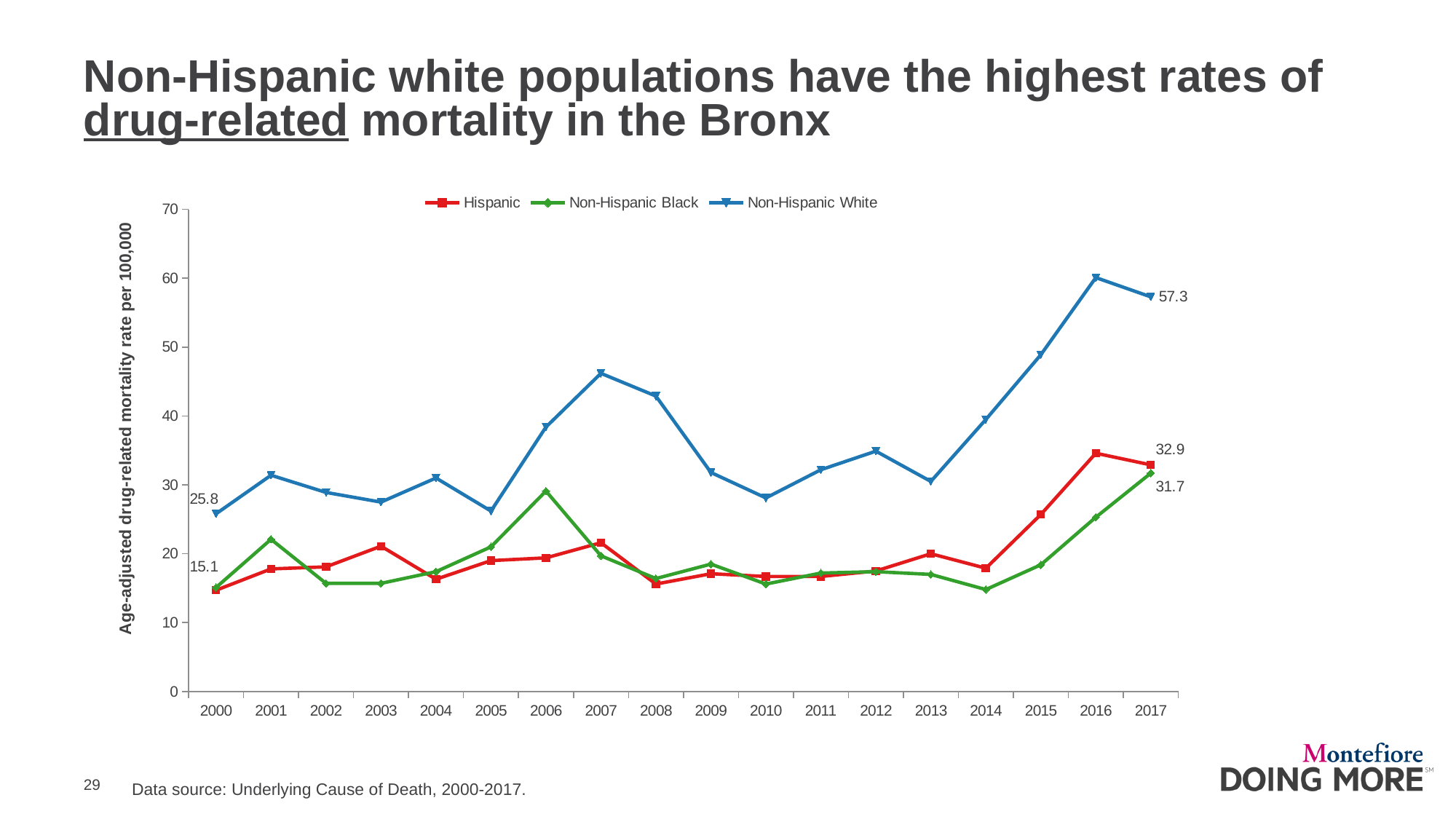
By how much did the Non-Hispanic White rate increase from 2000 to 2017? 31.5 How many years are shown on the x axis? 18 What is the value for the Non-Hispanic Black series in 2017? 31.7 What is the value for the Non-Hispanic White series in 2000? 25.8 Which series has the highest value in 2017? Non-Hispanic White What is the difference between the Non-Hispanic White and Hispanic values in 2017? 24.4 In 2017, which is larger: the Hispanic value or the Non-Hispanic Black value? Hispanic How many series does the legend list? 3 What is the value for the Hispanic series in 2017? 32.9 What kind of chart is shown on the slide? line chart What is the age-adjusted drug-related mortality rate for the Non-Hispanic White series in 2017? 57.3 Is the Non-Hispanic White value for 2016 greater or less than 50? greater